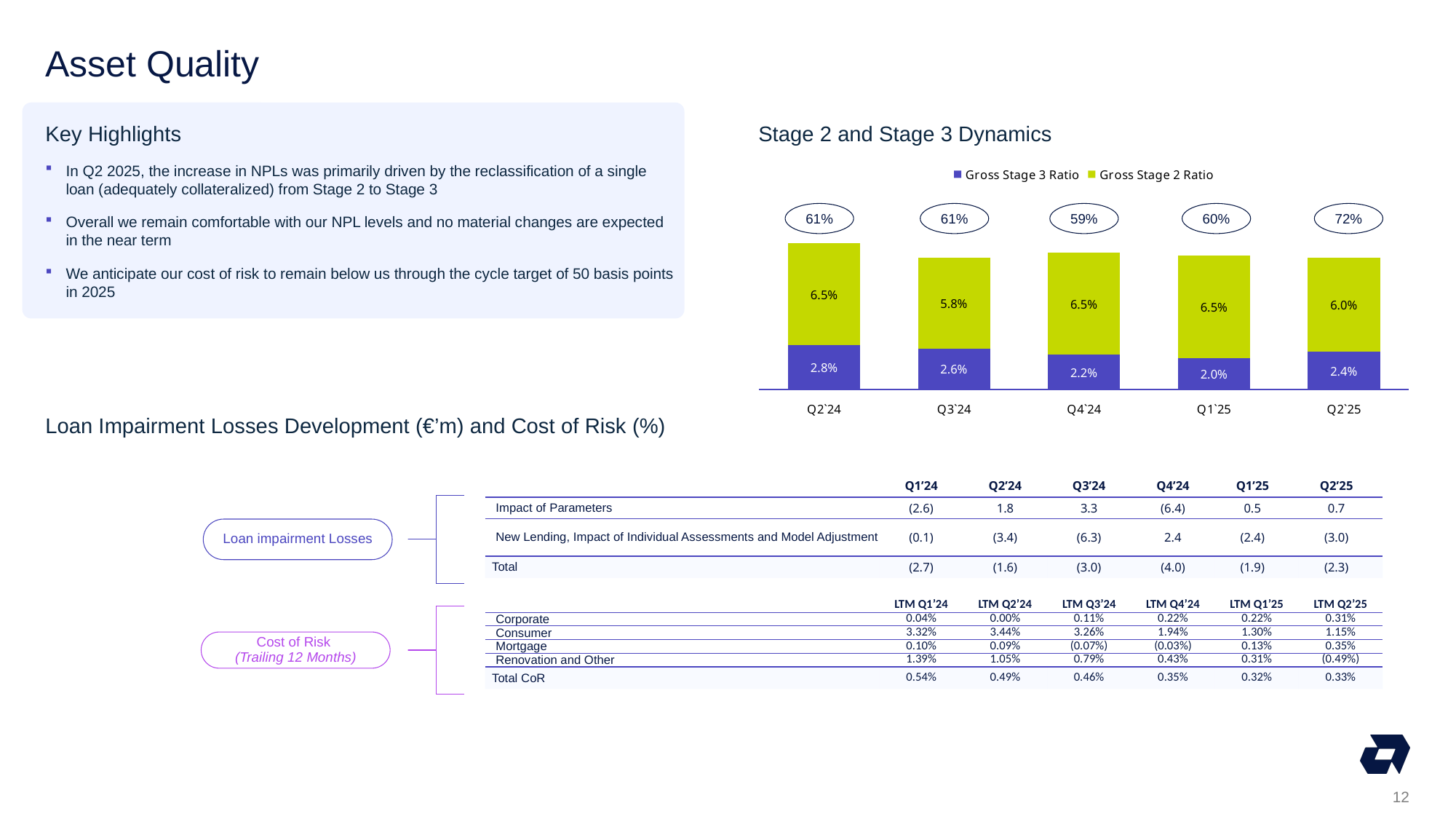
How many series does the legend of the Stage 2 and Stage 3 Dynamics chart list? 2 In the Stage 2 and Stage 3 Dynamics chart, what is the combined Stage 2 and Stage 3 ratio for Q2`24? 9.3% In the Stage 2 and Stage 3 Dynamics chart, what is the difference between the Gross Stage 3 Ratio in Q2`24 and Q1`25? 0.8% What type of chart is the Stage 2 and Stage 3 Dynamics chart? Stacked bar chart How many quarters are shown on the x axis of the Stage 2 and Stage 3 Dynamics chart? 5 In the Stage 2 and Stage 3 Dynamics chart, what is the Gross Stage 3 Ratio for Q2`25? 2.4% In the Stage 2 and Stage 3 Dynamics chart, what is the combined Stage 2 and Stage 3 ratio for Q2`25? 8.4% In the Stage 2 and Stage 3 Dynamics chart, which quarter has the highest Gross Stage 3 Ratio? Q2`24 In the Stage 2 and Stage 3 Dynamics chart, which quarter has the lowest Gross Stage 3 Ratio? Q1`25 In the Stage 2 and Stage 3 Dynamics chart, what is the Gross Stage 2 Ratio for Q3`24? 5.8% In the Stage 2 and Stage 3 Dynamics chart, is the Gross Stage 2 Ratio higher in Q3`24 or Q2`25? Q2`25 In the Stage 2 and Stage 3 Dynamics chart, what is the Gross Stage 3 Ratio for Q2`24? 2.8%